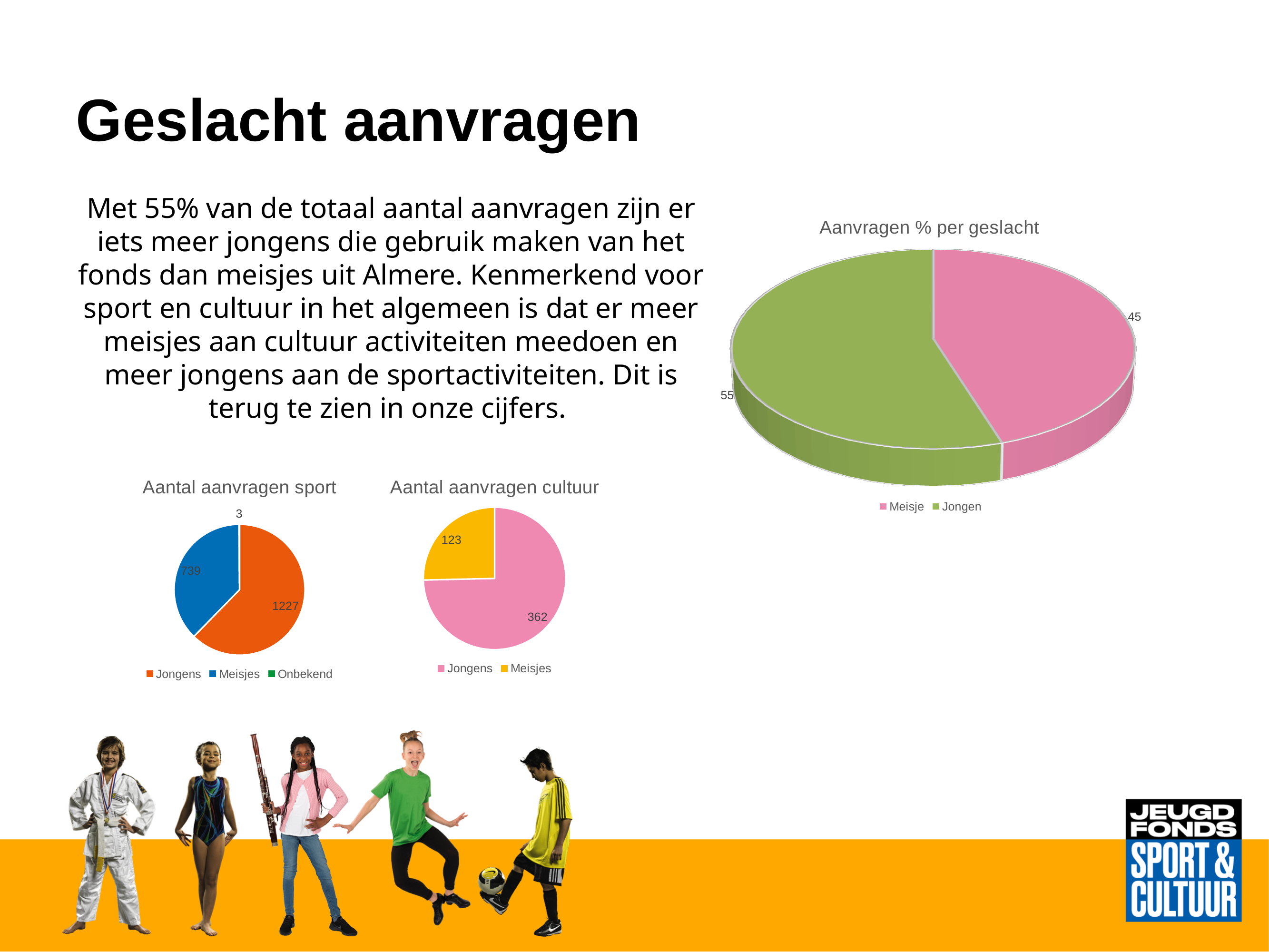
In the 'Aantal aanvragen cultuur' chart, what is the value for Meisjes? 123 In the 'Aantal aanvragen sport' chart, what is the value for Meisjes? 739 In the 'Aantal aanvragen cultuur' chart, what is the value for Jongens? 362 In the 'Aantal aanvragen sport' chart, what is the difference between Jongens and Meisjes? 488 In the 'Aantal aanvragen cultuur' chart, what is the total of Jongens and Meisjes? 485 In the 'Aantal aanvragen sport' chart, what is the value for Onbekend? 3 In the 'Aantal aanvragen sport' chart, how many categories does the legend list? 3 In the 'Aanvragen % per geslacht' chart, what is the value for Jongen? 55 In the 'Aanvragen % per geslacht' chart, what is the value for Meisje? 45 In the 'Aantal aanvragen sport' chart, what is the value for Jongens? 1227 What kind of chart is 'Aantal aanvragen cultuur'? Pie chart In the 'Aanvragen % per geslacht' chart, which category has the larger share? Jongen